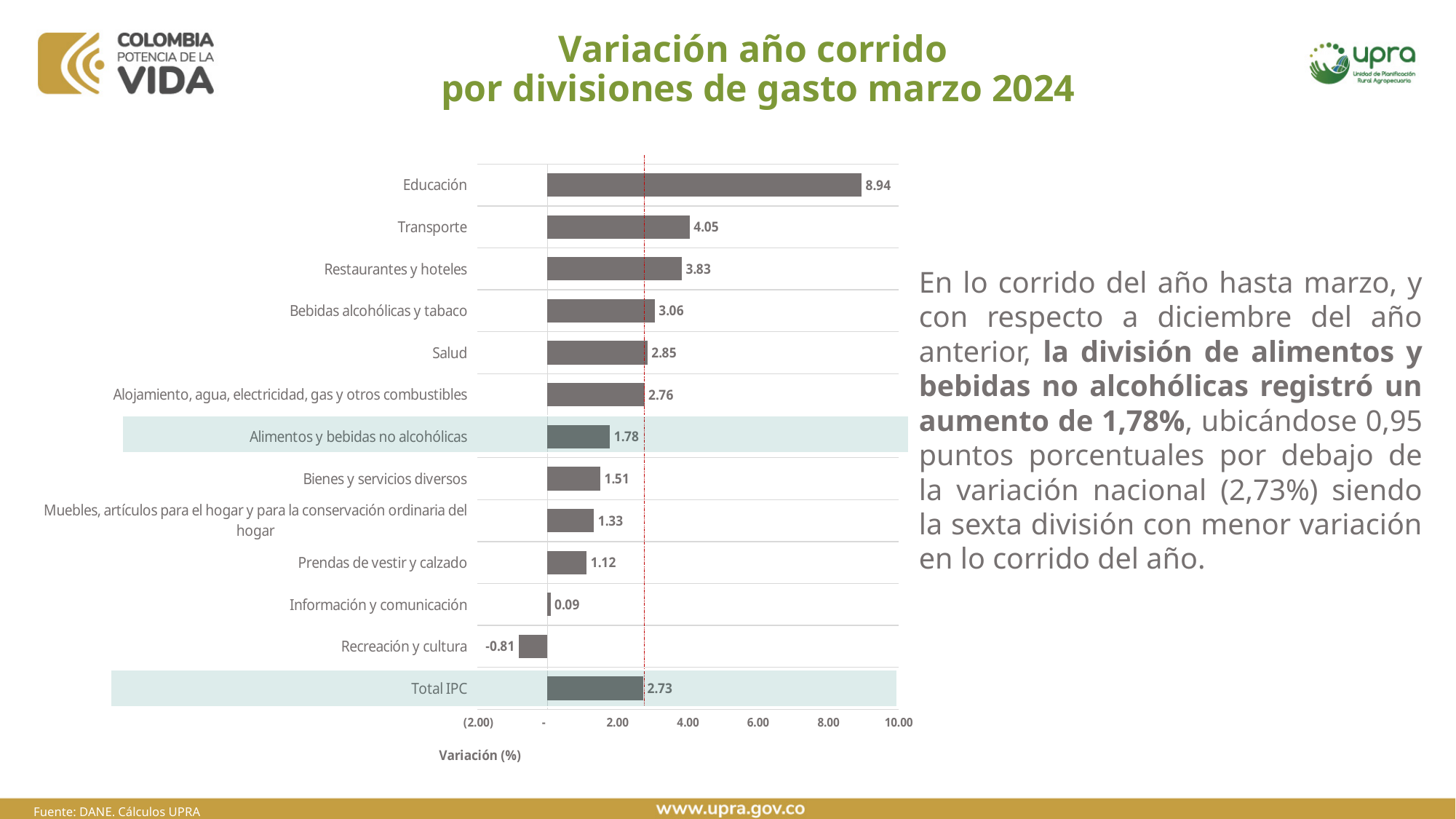
Which is larger, the value for Salud or the value for Bebidas alcohólicas y tabaco? Bebidas alcohólicas y tabaco What is the value for Recreación y cultura? -0.81 What is the value for Alimentos y bebidas no alcohólicas? 1.78 What is the label of the horizontal axis? Variación (%) What kind of chart is shown on the slide? Bar chart Which category has the lowest value? Recreación y cultura Which category has the highest value? Educación What is the value for Educación? 8.94 What is the value for Total IPC? 2.73 What is the difference between the values for Transporte and Restaurantes y hoteles? 0.22 What is the difference between the values for Total IPC and Alimentos y bebidas no alcohólicas? 0.95 How many categories are shown in the chart? 13